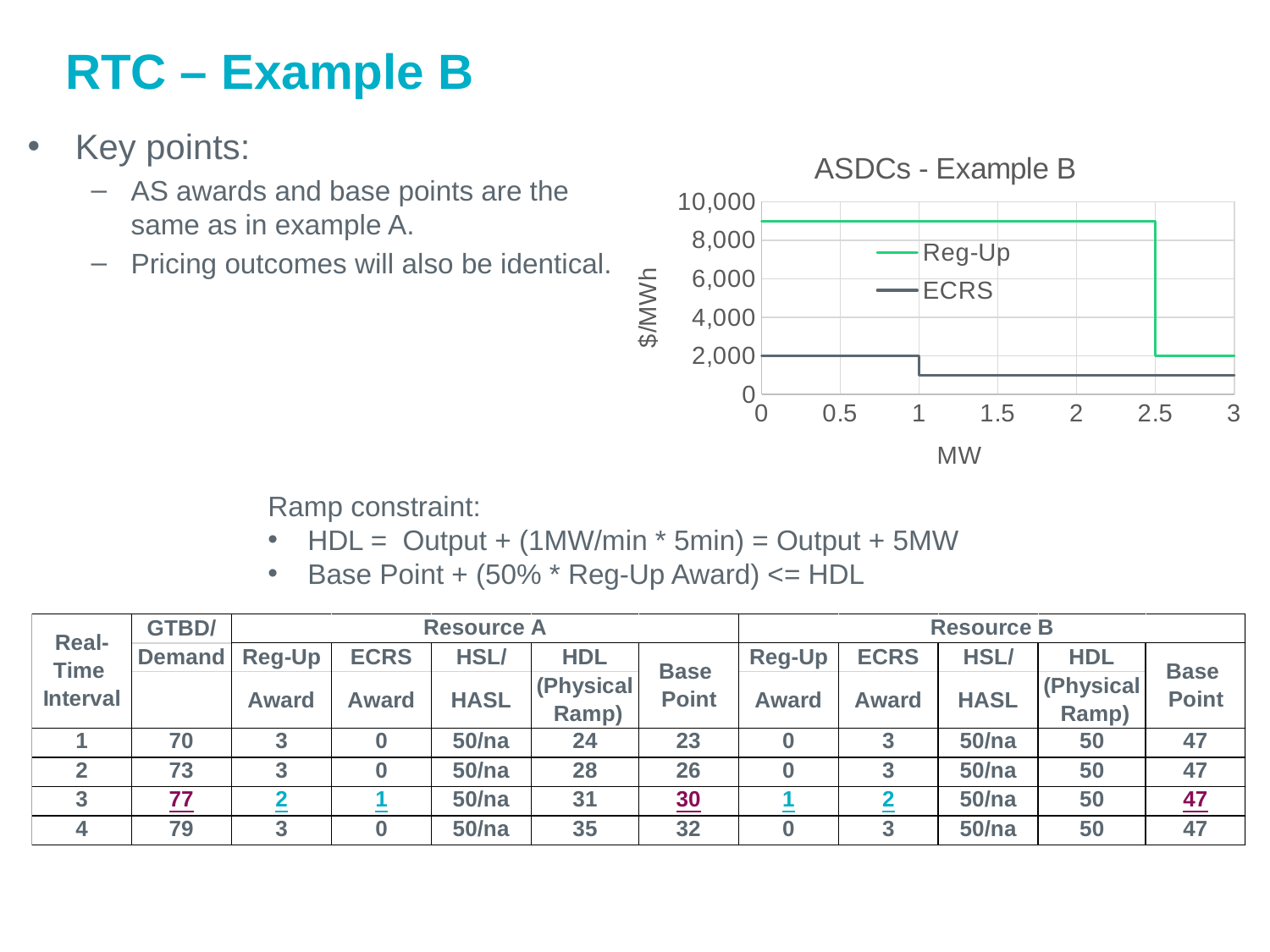
Is the ECRS value at 2 MW greater or less than 2,000? less Which series in the chart is drawn in green? Reg-Up Is the Reg-Up value at 3 MW greater or less than 6,000? less What is the title of the chart on the slide? ASDCs - Example B What is the ECRS value in $/MWh at 0.5 MW? 2,000 Does the ECRS series rise or fall as MW increases from 0 to 3? fall How many series does the legend of the ASDCs - Example B chart list? 2 Does the Reg-Up series rise or fall as MW increases from 0 to 3? fall At 1.5 MW, which series has the higher $/MWh value, Reg-Up or ECRS? Reg-Up What kind of chart is shown on the slide? line chart Is the ECRS value at 0.5 MW greater or less than 4,000? less